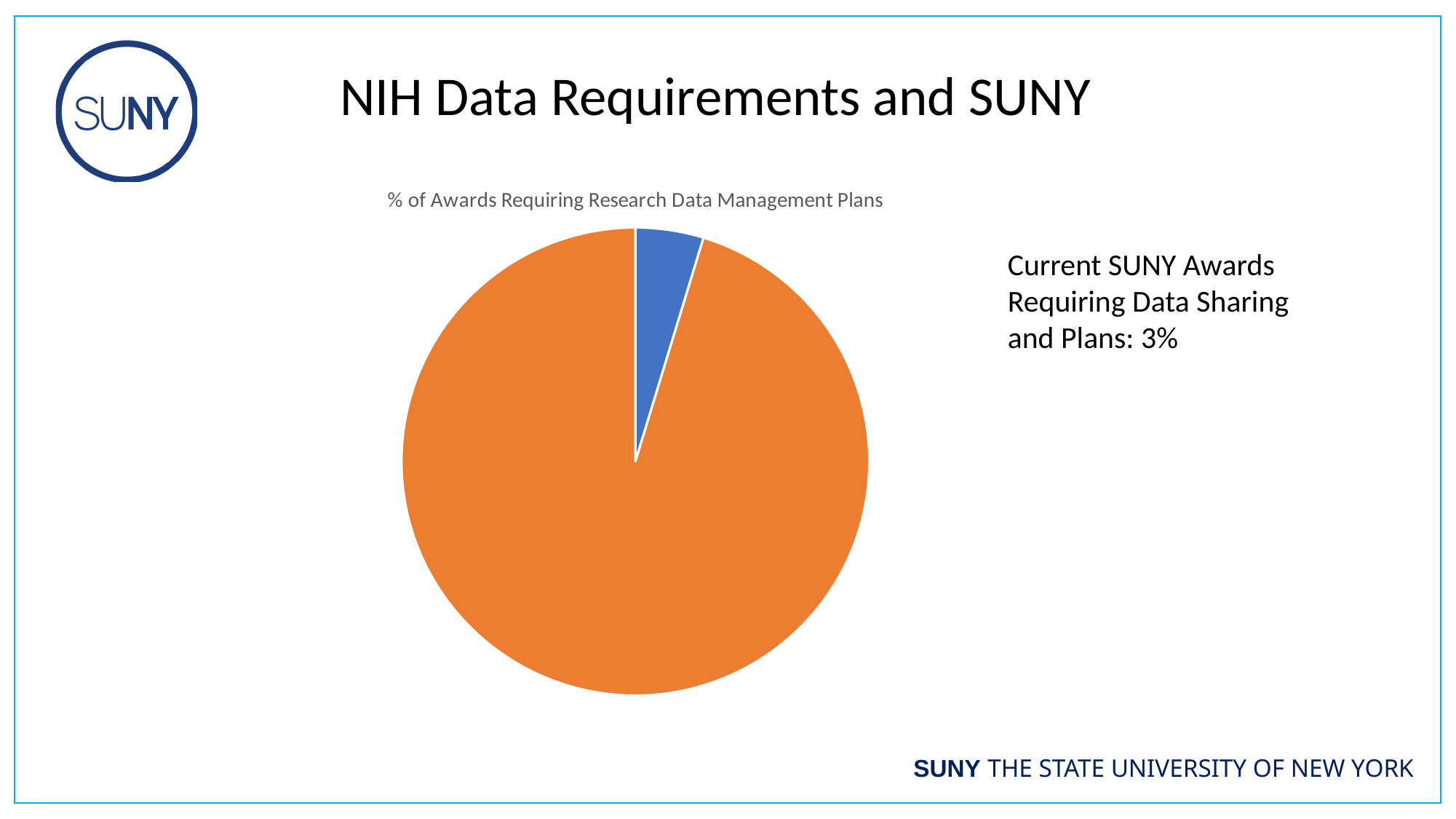
What kind of chart is shown on the slide? Pie chart Which slice of the pie chart is larger, the orange one or the blue one? The orange one According to the text on the slide, what percentage of current SUNY awards require data sharing and plans? 3% Which slice of the pie chart is the smallest? The blue slice How many slices does the pie chart have? 2 Is the blue slice's share of the pie greater or less than 50%? less What is the title of the pie chart? % of Awards Requiring Research Data Management Plans